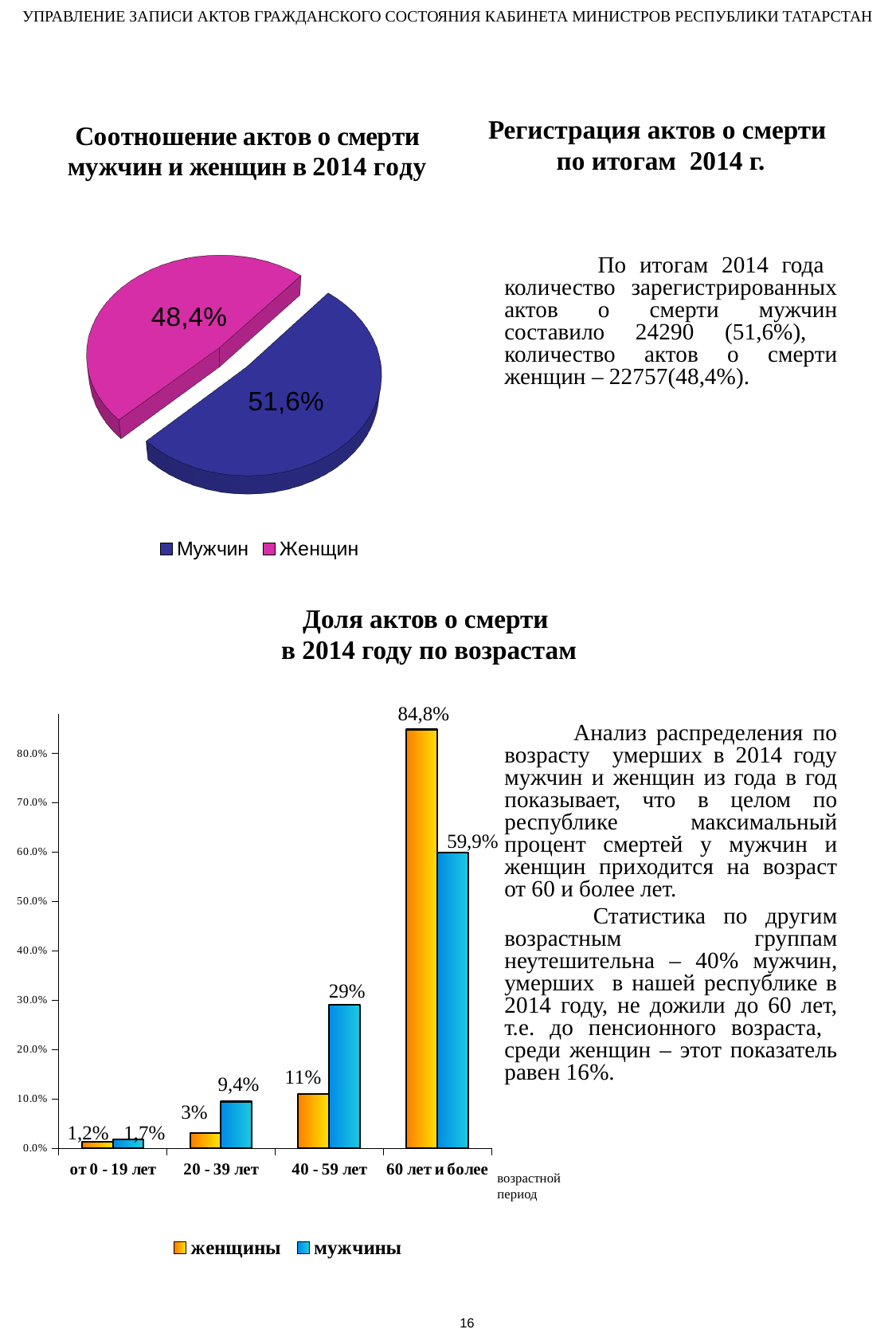
In the bar chart 'Доля актов о смерти в 2014 году по возрастам', what is the difference between женщины and мужчины in the '60 лет и более' group? 24,9% In the bar chart 'Доля актов о смерти в 2014 году по возрастам', what is the value for мужчины in the '40 - 59 лет' group? 29% In the bar chart 'Доля актов о смерти в 2014 году по возрастам', which age group has the lowest value for женщины? от 0 - 19 лет In the pie chart 'Соотношение актов о смерти мужчин и женщин в 2014 году', what share is shown for Женщин? 48,4% In the bar chart 'Доля актов о смерти в 2014 году по возрастам', how many age groups are shown on the x axis? 4 What type of chart is 'Соотношение актов о смерти мужчин и женщин в 2014 году'? Pie chart In the pie chart 'Соотношение актов о смерти мужчин и женщин в 2014 году', what share is shown for Мужчин? 51,6% In the bar chart 'Доля актов о смерти в 2014 году по возрастам', how many series does the legend list? 2 In the bar chart 'Доля актов о смерти в 2014 году по возрастам', do the values for мужчины rise or fall from the youngest to the oldest age group? Rise In the bar chart 'Доля актов о смерти в 2014 году по возрастам', what is the value for женщины in the '60 лет и более' group? 84,8% In the bar chart 'Доля актов о смерти в 2014 году по возрастам', which age group has the highest value for мужчины? 60 лет и более In the pie chart 'Соотношение актов о смерти мужчин и женщин в 2014 году', which slice is larger, Мужчин or Женщин? Мужчин